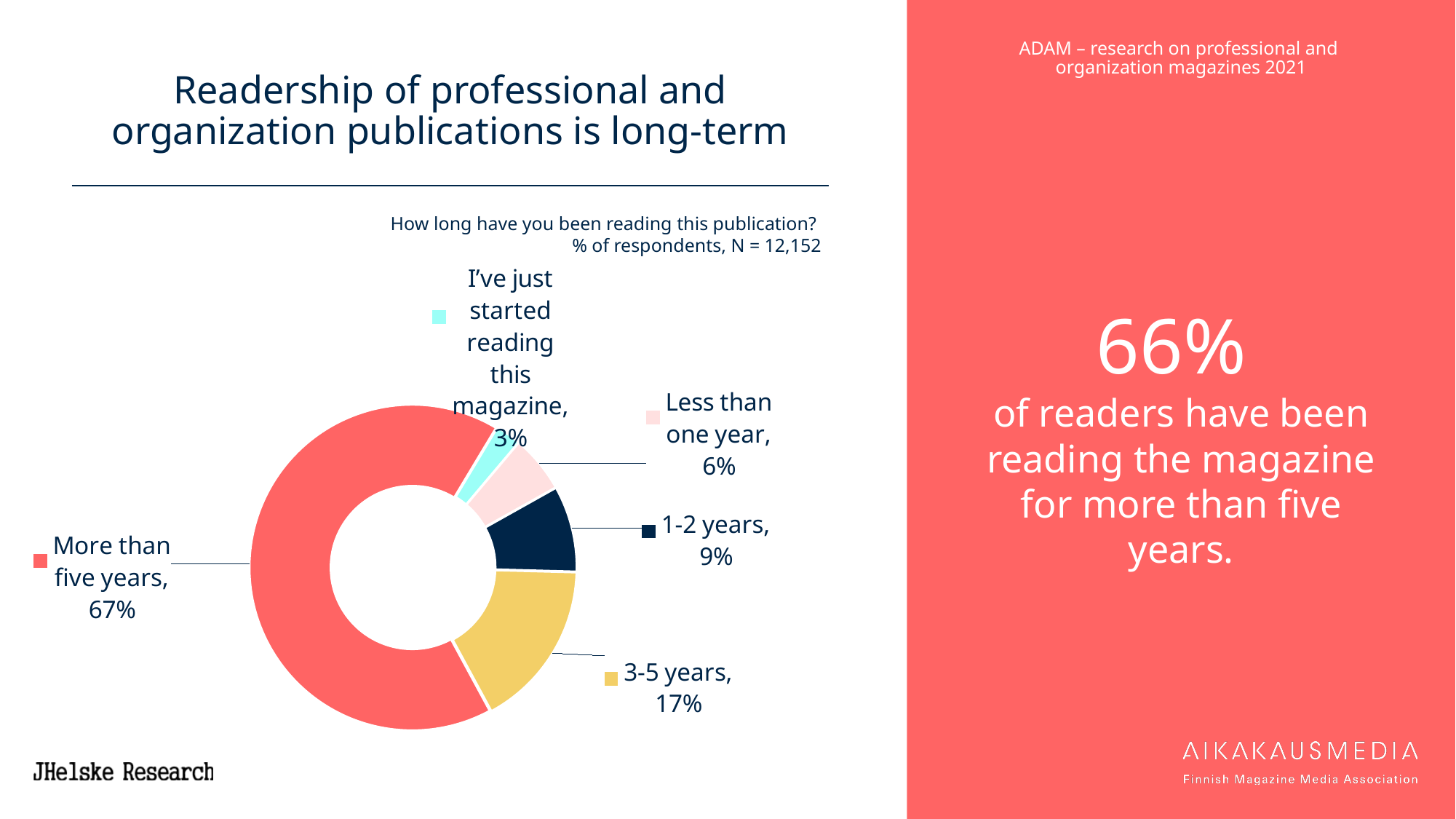
Which is larger: the share for '1-2 years' or the share for 'Less than one year'? 1-2 years Which category has the smallest share of respondents? I've just started reading this magazine What share of respondents have been reading the publication for 3-5 years? 17% What is the sample size (N) stated above the chart? 12,152 What percentage of respondents have been reading the publication for more than five years? 67% How many categories are shown in the chart? 5 Which category has the largest share of respondents? More than five years What kind of chart is shown on the slide? Pie chart (donut) What percentage of respondents say they have just started reading the magazine? 3% What is the difference in percentage points between the 'More than five years' and '3-5 years' categories? 50 What percentage of respondents have been reading the publication for 1-2 years? 9% What percentage of respondents have been reading the publication for less than one year? 6%